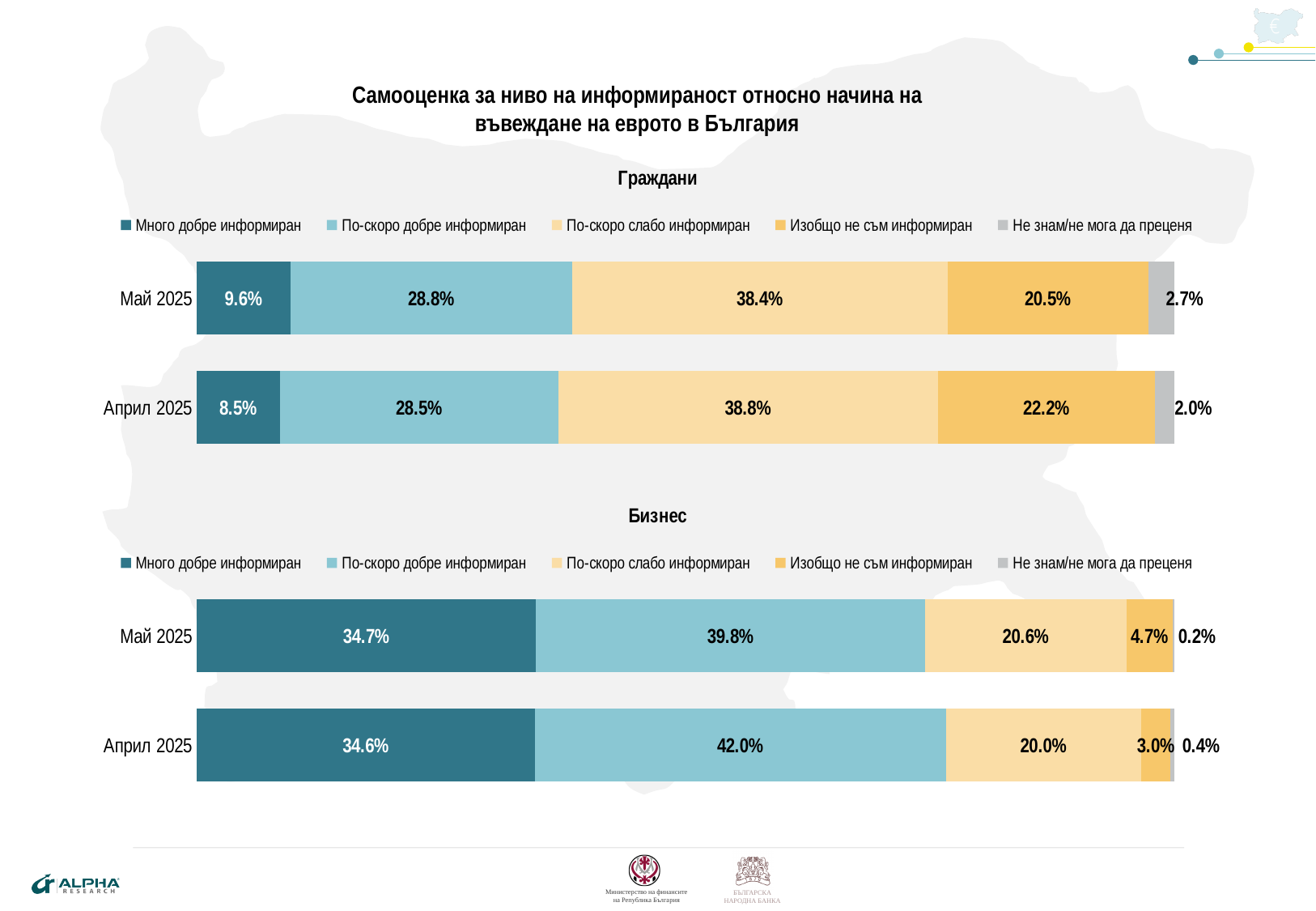
How many series does the legend of the Бизнес chart list? 5 In the Граждани chart, which is larger: Много добре информиран in Май 2025 or in Април 2025? Май 2025 In the Граждани chart, what is the value for Много добре информиран in Април 2025? 8.5% What kind of chart is the Граждани chart? Stacked bar chart In the Бизнес chart, what is the difference between the По-скоро добре информиран values for Април 2025 and Май 2025? 2.2 percentage points In the Бизнес chart, what is the value for По-скоро добре информиран in Април 2025? 42.0% In the Граждани chart, which category has the highest value in Май 2025? По-скоро слабо информиран In the Бизнес chart, what is the value for Изобщо не съм информиран in Май 2025? 4.7% In the Граждани chart, what is the difference between the Изобщо не съм информиран values for Април 2025 and Май 2025? 1.7 percentage points In the Бизнес chart, which category has the lowest value in Април 2025? Не знам/не мога да преценя In the Бизнес chart, what is the total of the Май 2025 bar? 100.0% In the Граждани chart, what is the value for По-скоро слабо информиран in Май 2025? 38.4%